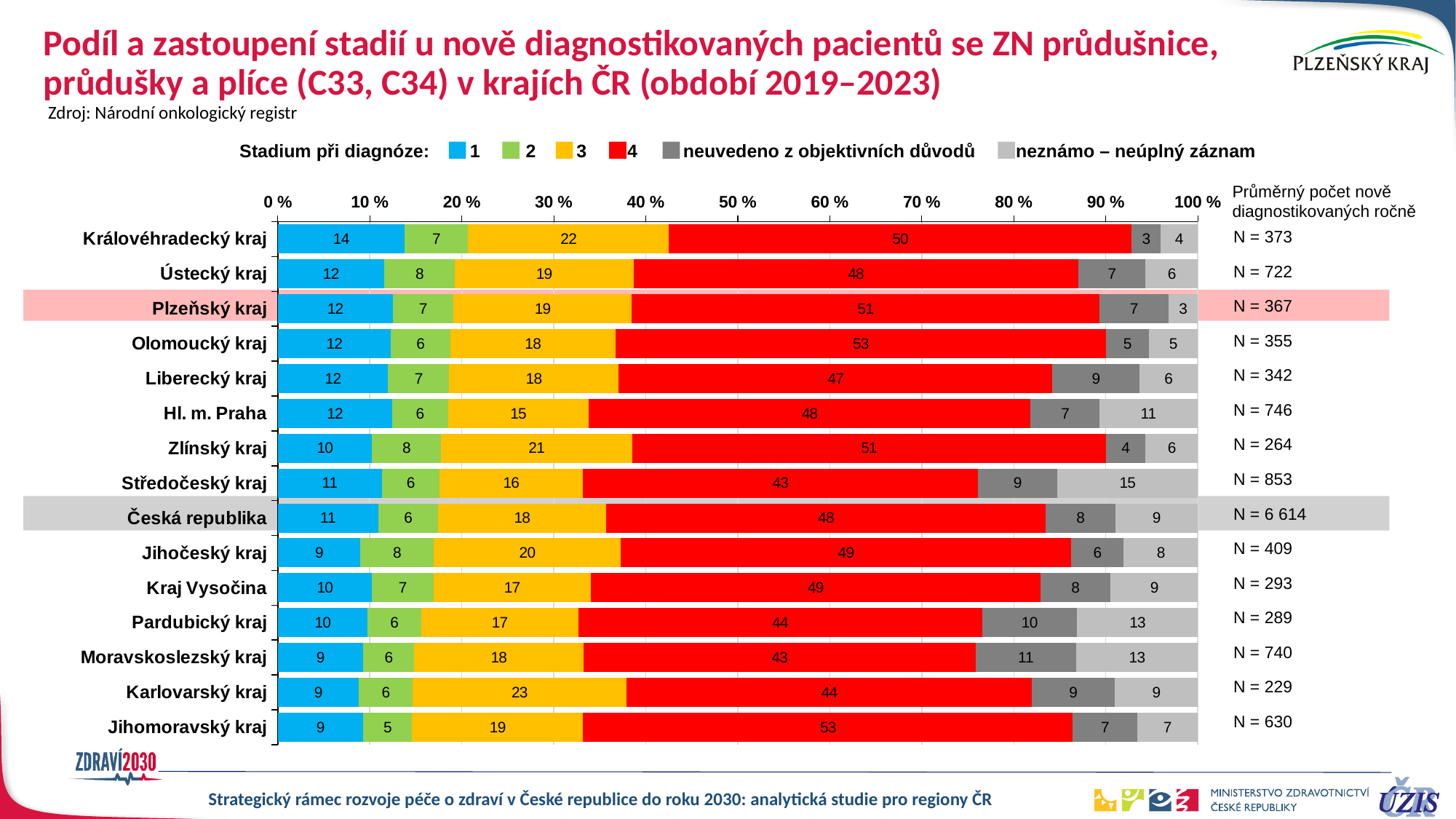
Which is larger: the stage 3 value for Hl. m. Praha or for Zlínský kraj? Zlínský kraj Which region has the highest value for 'neuvedeno z objektivních důvodů'? Moravskoslezský kraj What is the average annual number of newly diagnosed patients (N) shown for Česká republika? N = 6 614 What is the difference between the stage 4 value for Olomoucký kraj and for Středočeský kraj? 10 What is the value of stage 4 for Plzeňský kraj? 51 What type of chart is shown on the slide? Stacked bar chart Which region has the highest value for stage 3? Karlovarský kraj What is the value of stage 1 for Královéhradecký kraj? 14 How many series does the legend list? 6 What is the value of 'neznámo – neúplný záznam' for Středočeský kraj? 15 How many regions (categories) are plotted in the chart? 15 Which region has the lowest value for stage 2? Jihomoravský kraj